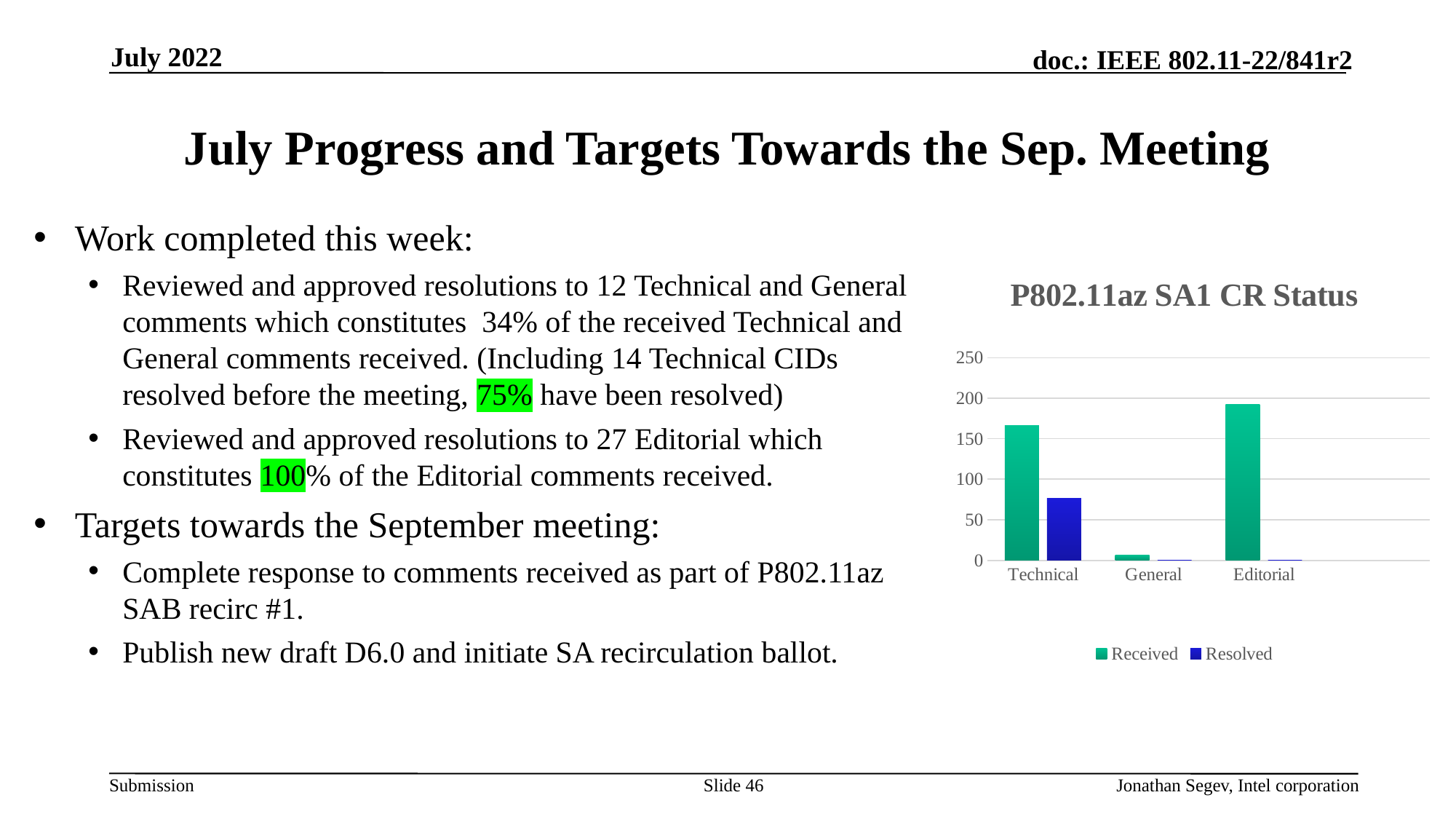
How many series does the chart's legend list? 2 Which category has the highest Resolved value? Technical Is the Received value for Technical greater or less than 150? greater What kind of chart is shown on the slide? bar chart Which category has the lowest Received value? General Which category has the highest Received value? Editorial Which is larger, the Received value for Editorial or the Received value for Technical? Editorial Is the Resolved value for Technical greater or less than 100? less Is the Received value for Editorial greater or less than 200? less Which series is shown in blue in the chart's legend? Resolved What is the title of the chart? P802.11az SA1 CR Status How many categories are shown on the x axis of the chart? 3